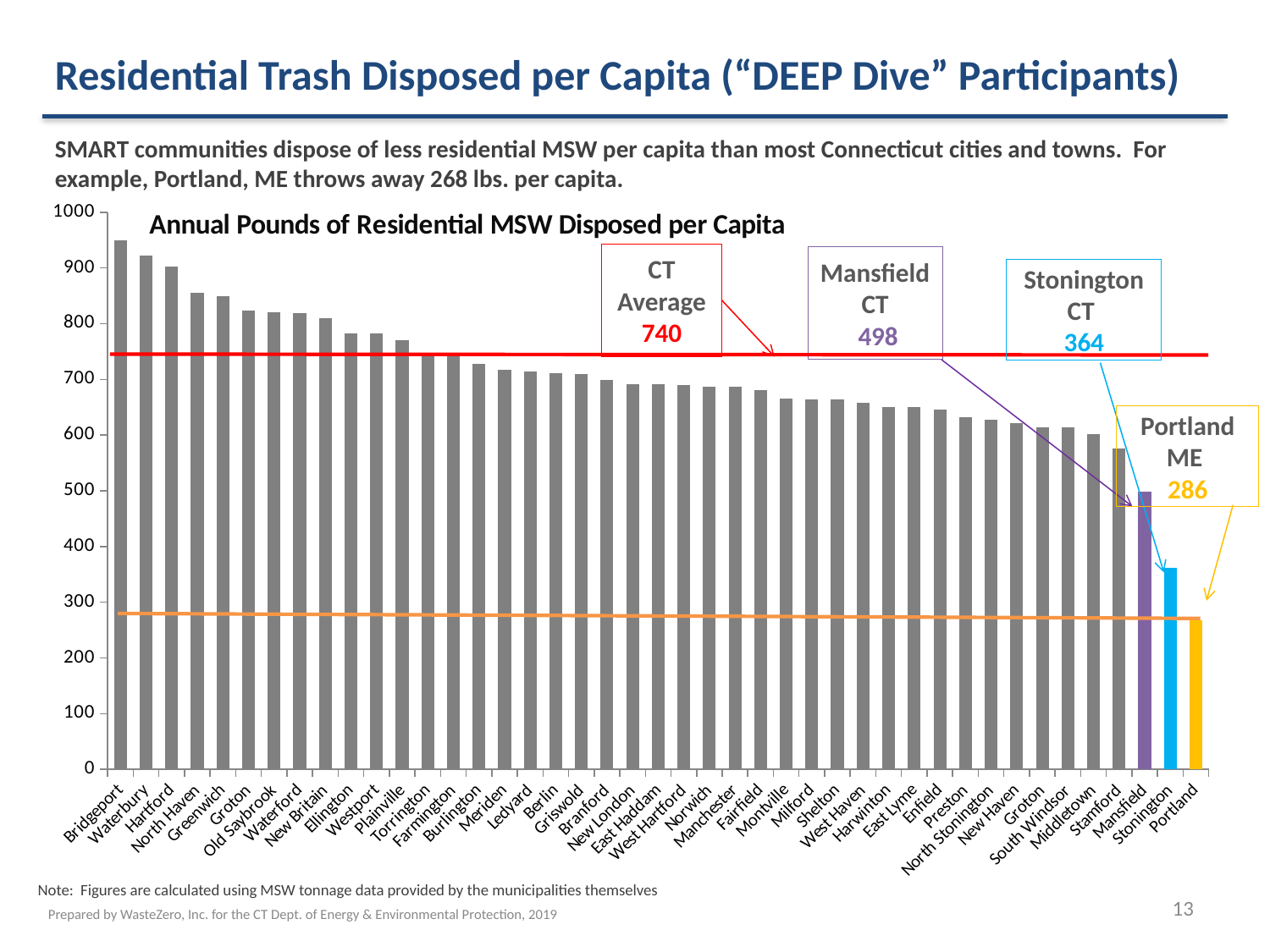
Do the bar values generally rise or fall from left to right along the x axis? fall Which has a larger value, Mansfield or Stonington? Mansfield What is the CT Average value shown on the chart? 740 Which municipality has the highest bar on the chart? Bridgeport Is the value for Westport greater or less than 700? greater What is the difference between the values for Mansfield CT and Stonington CT? 134 What is the value shown for Mansfield CT? 498 Is the value for Bridgeport greater or less than 900? greater What is the title of the chart? Annual Pounds of Residential MSW Disposed per Capita What is the value shown for Stonington CT? 364 What kind of chart is shown on the slide? bar chart Which municipality has the lowest bar on the chart? Portland